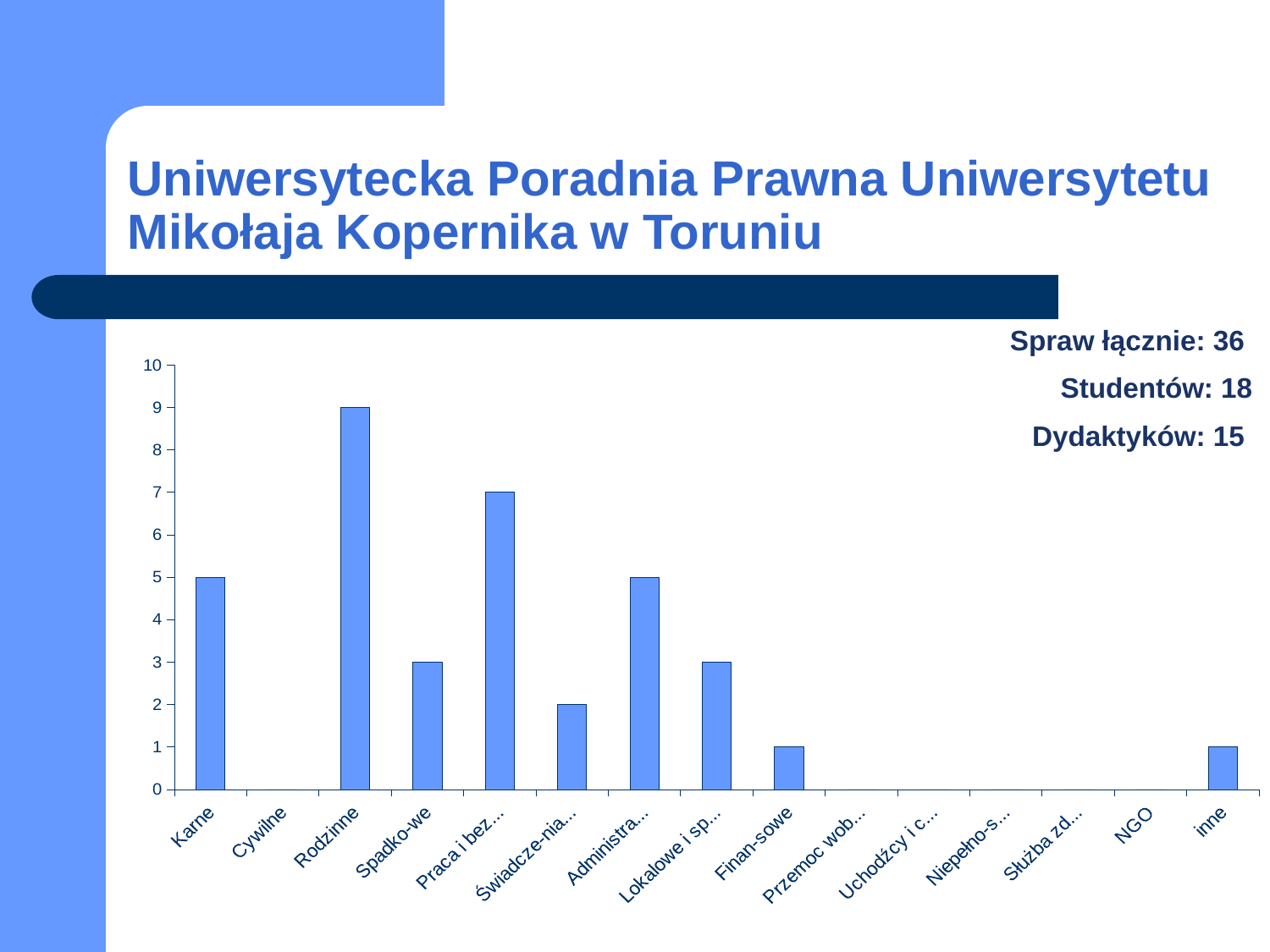
Is the value for Rodzinne greater or less than 8? greater What is the value for NGO? 0 What is the difference between the values for Rodzinne and Karne? 4 What is the value for Karne? 5 What is the value for Spadko-we? 3 What is the value for Rodzinne? 9 Which is larger, the value for Spadko-we or the value for Finan-sowe? Spadko-we What kind of chart is shown on the slide? bar chart Which category has the highest value? Rodzinne What is the value for inne? 1 How many categories are shown on the x axis? 15 What is the value for Finan-sowe? 1